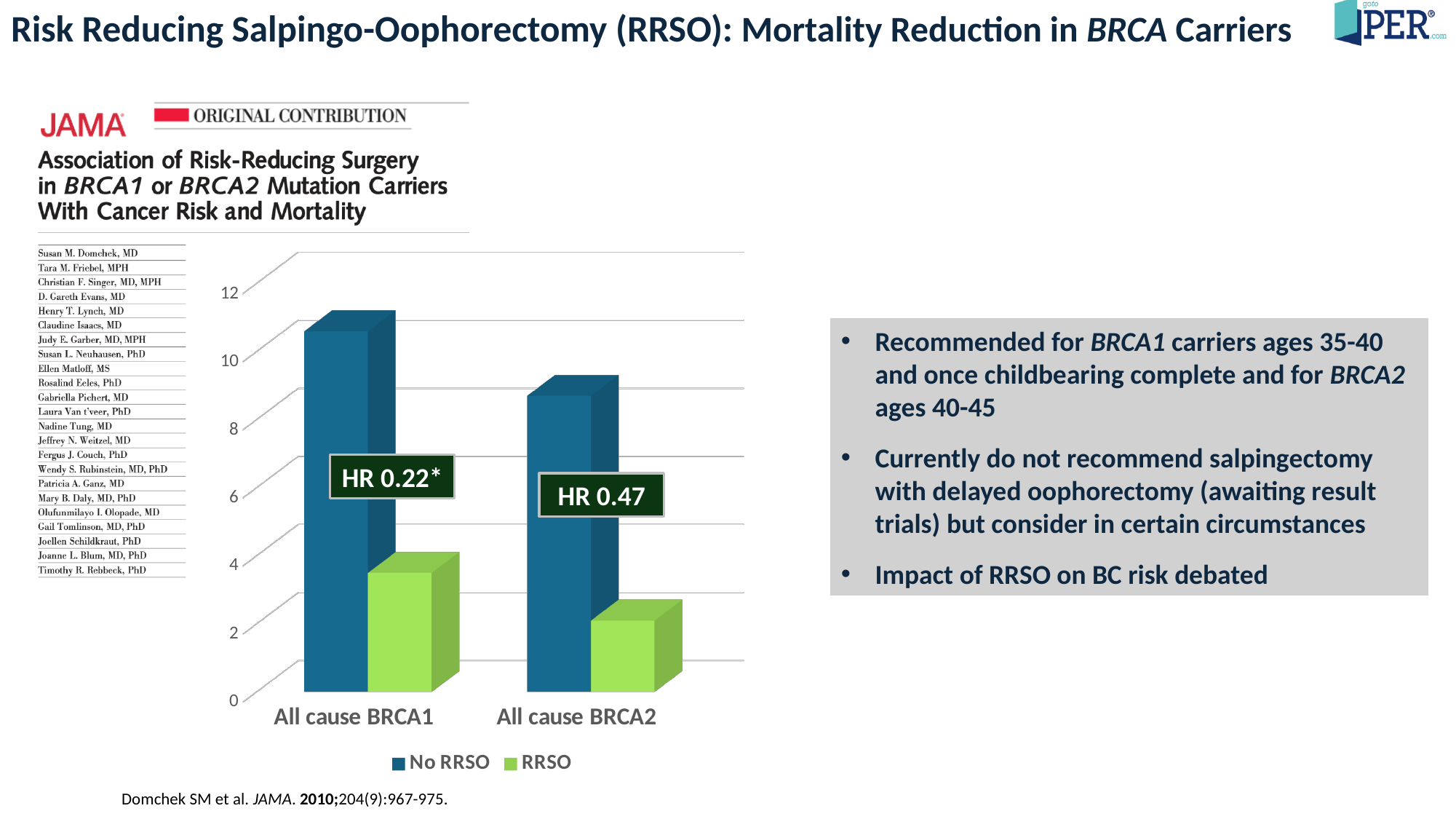
Which category has the lowest RRSO bar? All cause BRCA2 How many categories are shown on the x axis of the chart? 2 How many series does the chart legend list? 2 For All cause BRCA1, which is larger: the No RRSO bar or the RRSO bar? No RRSO What kind of chart is shown on the slide? bar chart Which series does the dark blue colour represent in the chart? No RRSO Which series does the green colour represent in the chart? RRSO Which category has the highest No RRSO bar? All cause BRCA1 Is the No RRSO value for All cause BRCA2 greater or less than 6? greater What hazard ratio is annotated on the chart for All cause BRCA2? HR 0.47 Is the RRSO value for All cause BRCA2 greater or less than 4? less Is the No RRSO value for All cause BRCA1 greater or less than 8? greater